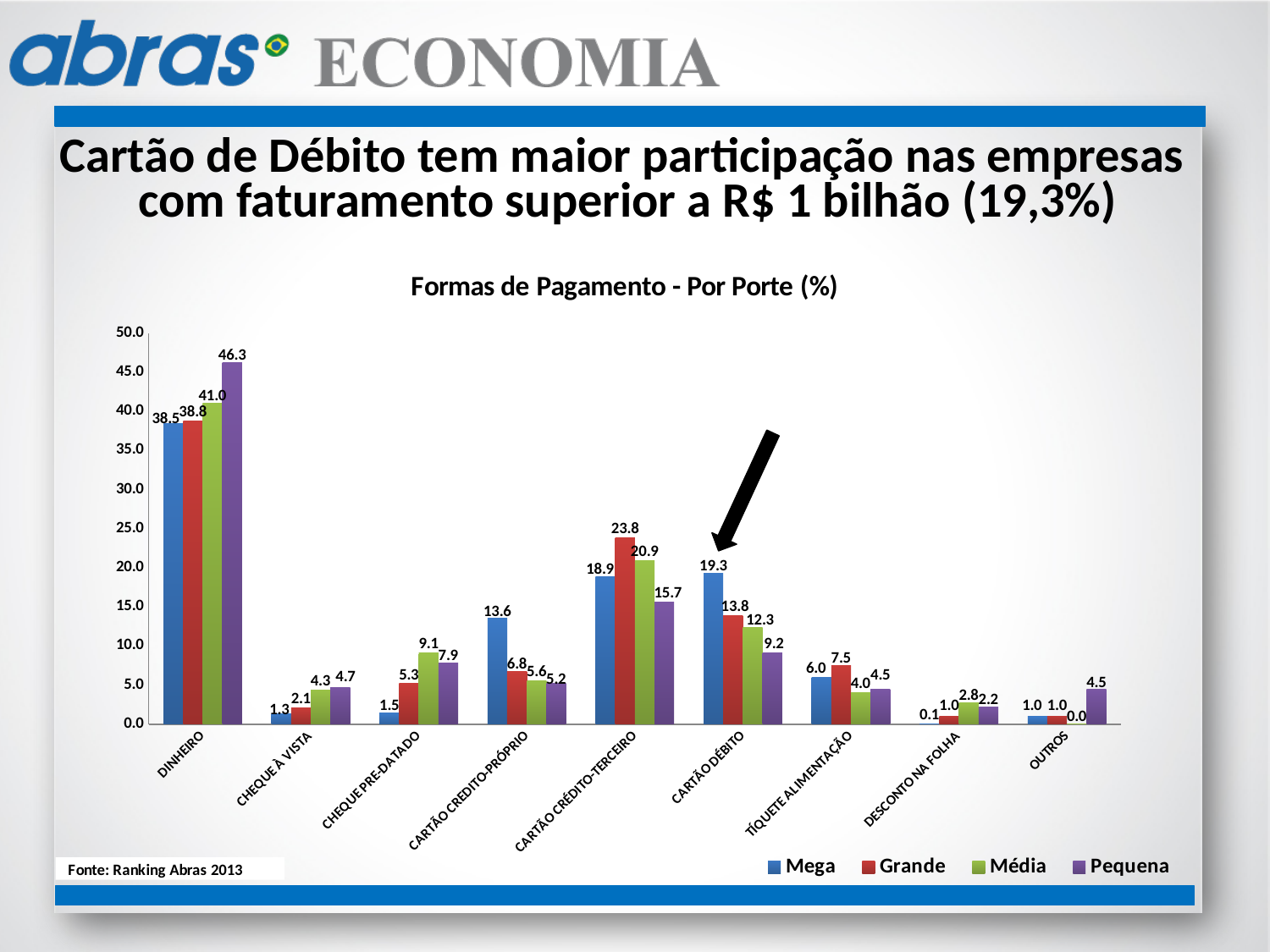
Which is larger in the CHEQUE PRE-DATADO category, the Média value or the Pequena value? Média What is the value for Pequena in the DINHEIRO category? 46.3 What is the value for Grande in the CARTÃO CRÉDITO-TERCEIRO category? 23.8 What is the value for Mega in the CARTÃO DÉBITO category? 19.3 What is the title of the chart? Formas de Pagamento - Por Porte (%) How many payment categories are shown on the x axis? 9 Which series has the lowest value in the DESCONTO NA FOLHA category? Mega What kind of chart is shown on the slide? Bar chart What is the difference between the Mega and Pequena values in the CARTÃO DÉBITO category? 10.1 Which category has the highest value for the Mega series? DINHEIRO How many series does the legend list? 4 What is the value for Média in the OUTROS category? 0.0